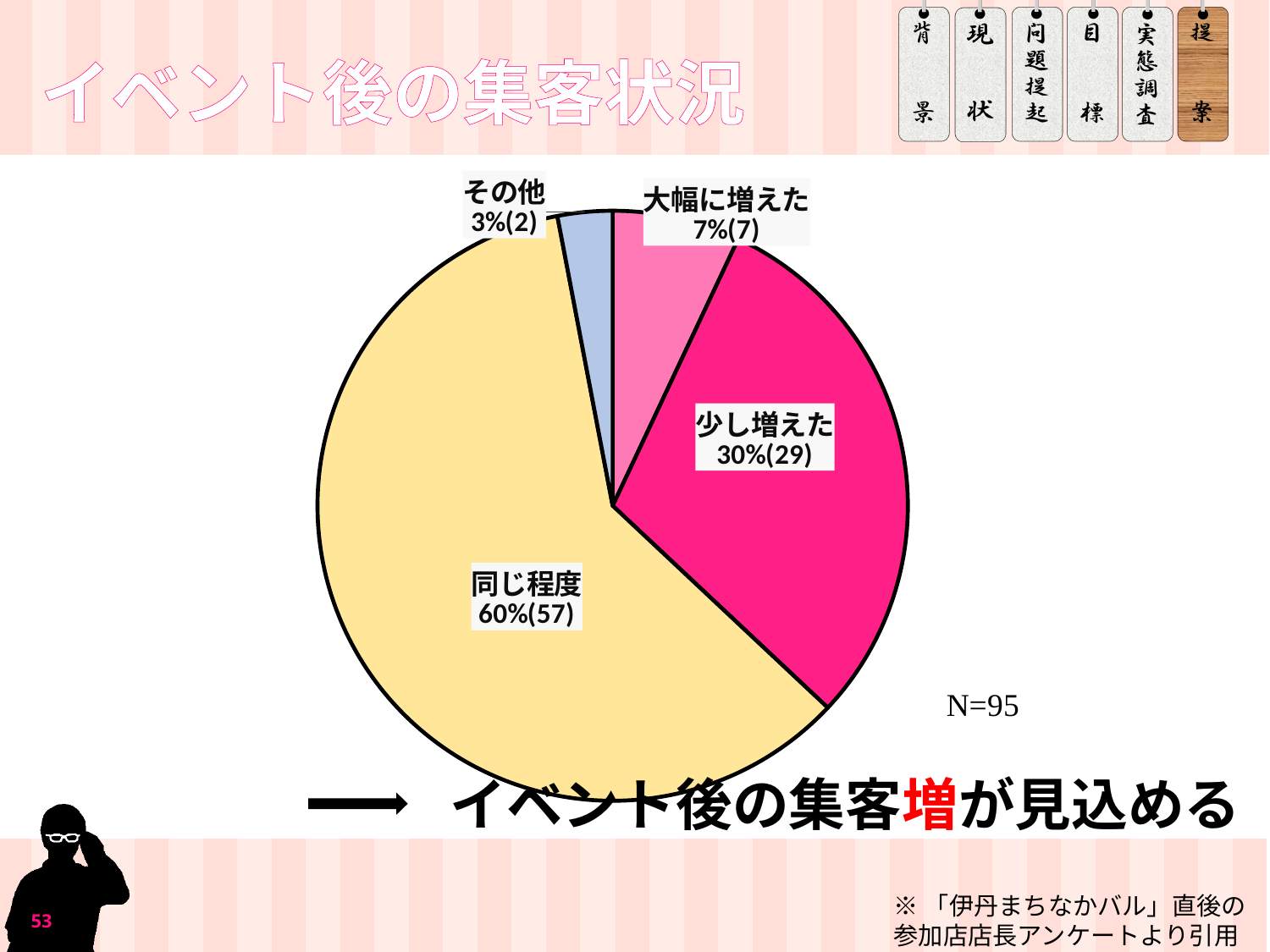
What percentage share does the 少し増えた slice have? 30% Which slice is larger, 大幅に増えた or 少し増えた? 少し増えた What percentage share does the 大幅に増えた slice have? 7% Which category has the smallest slice of the pie? その他 How many respondents are in the その他 category? 2 What percentage share does the 同じ程度 slice have? 60% How many slices does the pie chart have? 4 What is the difference in respondent count between 同じ程度 and 少し増えた? 28 How many respondents answered 少し増えた? 29 Which category has the largest slice of the pie? 同じ程度 What kind of chart is shown on the slide? Pie chart What is the total number of respondents (N) shown next to the chart? N=95